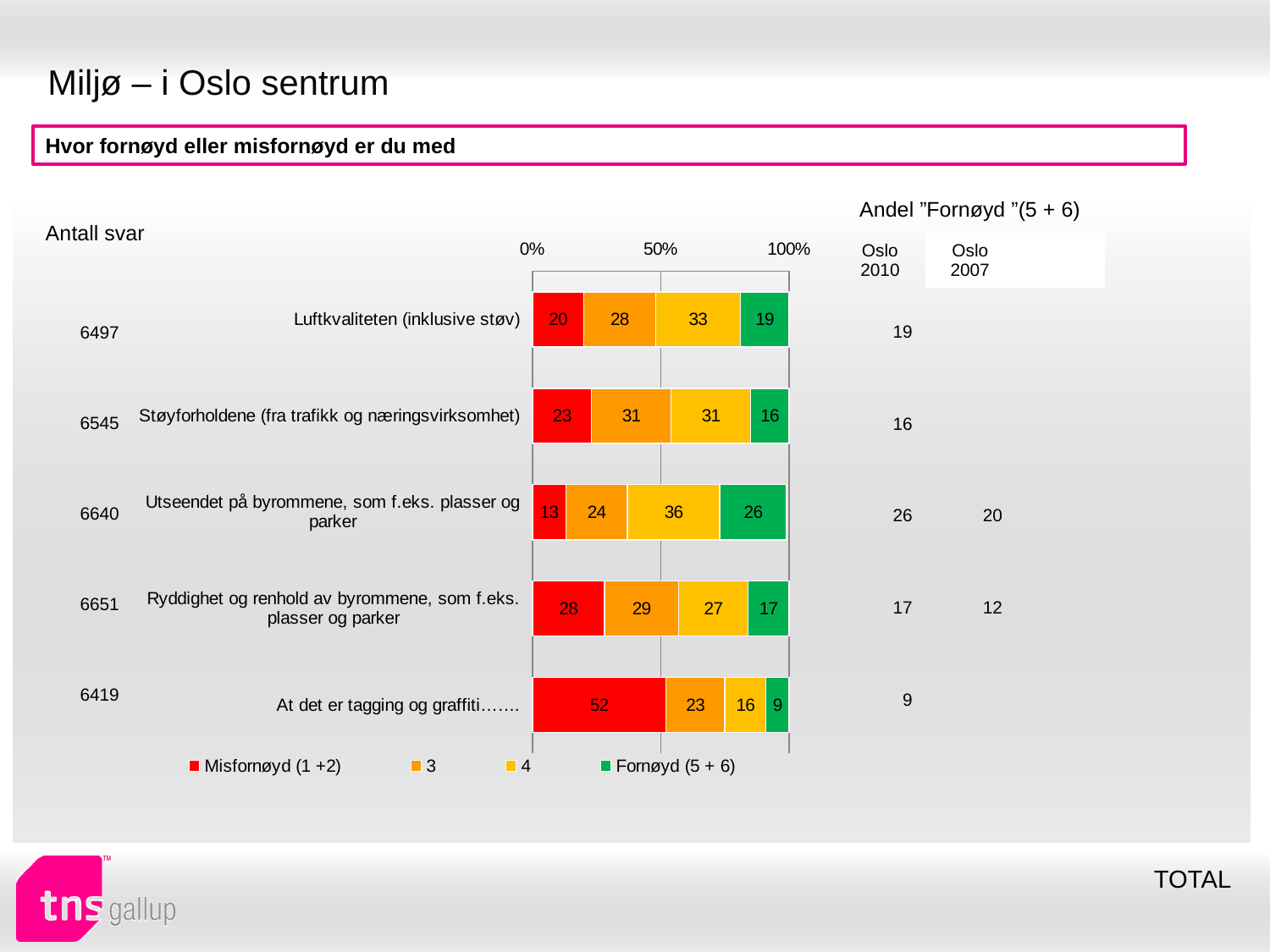
What is the total of the stacked bar for "Ryddighet og renhold av byrommene, som f.eks. plasser og parker"? 101 What is the value of series "4" for "Luftkvaliteten (inklusive støv)"? 33 Which category has the lowest Fornøyd (5 + 6) value? At det er tagging og graffiti……. What is the Misfornøyd (1 +2) value for "At det er tagging og graffiti……."? 52 How many categories are shown in the chart? 5 What is the value of series "3" for "Støyforholdene (fra trafikk og næringsvirksomhet)"? 31 Which has a larger Fornøyd (5 + 6) value: "Luftkvaliteten (inklusive støv)" or "Utseendet på byrommene, som f.eks. plasser og parker"? Utseendet på byrommene, som f.eks. plasser og parker What is the Fornøyd (5 + 6) value for "Utseendet på byrommene, som f.eks. plasser og parker"? 26 What kind of chart is shown on the slide? Stacked bar chart What is the difference between the Misfornøyd (1 +2) values for "At det er tagging og graffiti……." and "Luftkvaliteten (inklusive støv)"? 32 Which category has the highest Misfornøyd (1 +2) value? At det er tagging og graffiti……. How many series does the legend list? 4